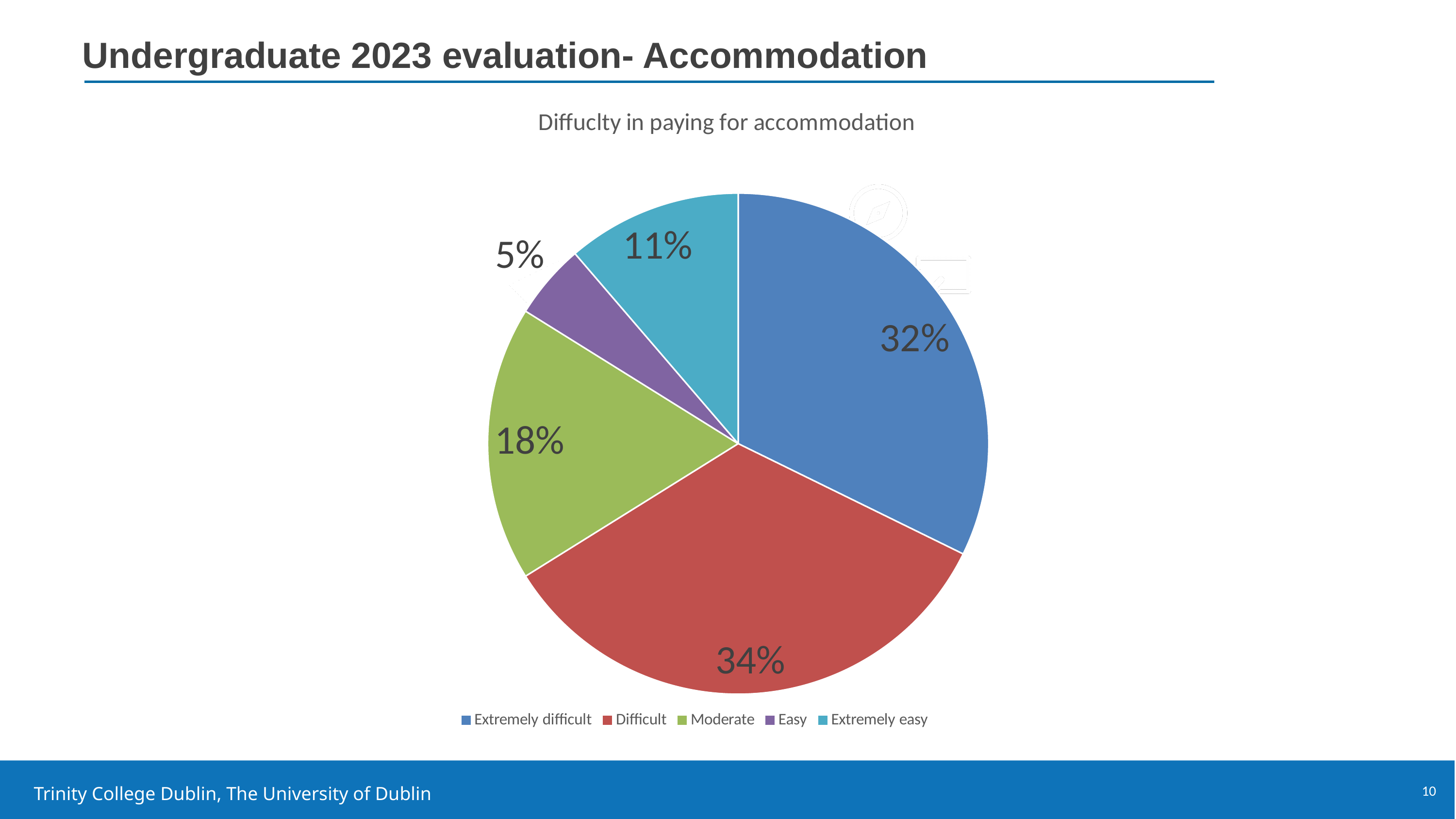
What is the title of the chart? Diffuclty in paying for accommodation Which category has the smallest share of the pie? Easy Which is larger, the Extremely difficult slice or the Moderate slice? Extremely difficult How many categories does the pie chart show? 5 What percentage of respondents found paying for accommodation Extremely easy? 11% What percentage of respondents found paying for accommodation Easy? 5% What kind of chart is shown on the slide? pie chart What percentage of respondents found paying for accommodation Difficult? 34% What is the difference in percentage points between the Moderate and Extremely easy slices? 7 What percentage of respondents found paying for accommodation Moderate? 18% What percentage of respondents found paying for accommodation Extremely difficult? 32% Which category has the largest share of the pie? Difficult